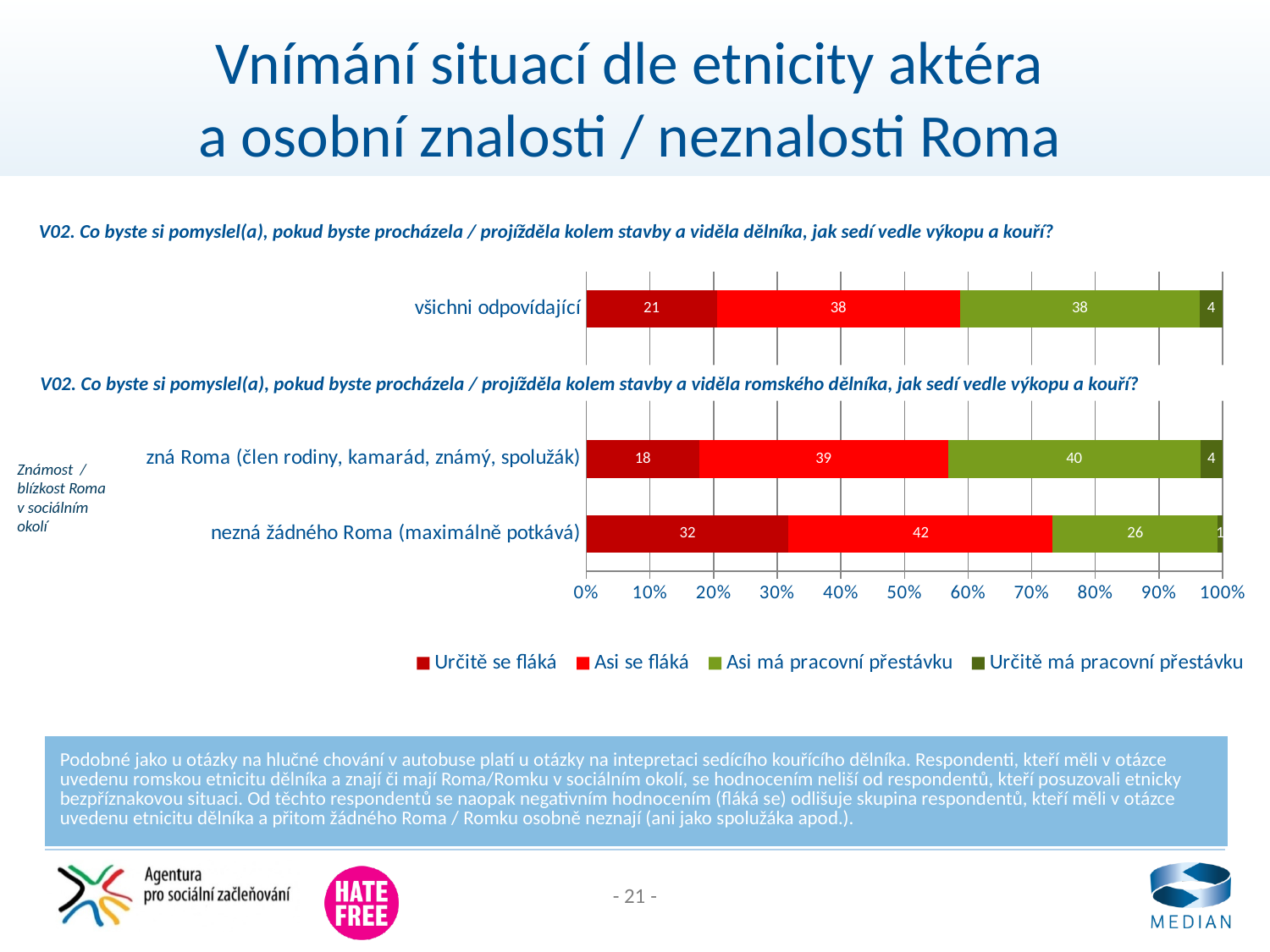
In the bottom chart, what is the value of 'Asi má pracovní přestávku' for 'zná Roma (člen rodiny, kamarád, známý, spolužák)'? 40 In the bottom chart, what is the value of 'Určitě má pracovní přestávku' for 'nezná žádného Roma (maximálně potkává)'? 1 Which legend entry is shown in dark green? Určitě má pracovní přestávku How many series does the legend list? 4 What kind of chart is used on the slide? stacked bar chart In the top chart, what is the combined value of 'Určitě se fláká' and 'Asi se fláká' for 'všichni odpovídající'? 59 In the bottom chart, which category has the higher value for 'Určitě se fláká'? nezná žádného Roma (maximálně potkává) In the top chart (všichni odpovídající), what is the value for 'Určitě se fláká'? 21 In the bottom chart, is 'Asi má pracovní přestávku' larger for 'zná Roma' or for 'nezná žádného Roma'? zná Roma (člen rodiny, kamarád, známý, spolužák) How many categories are shown in the bottom chart? 2 In the bottom chart, what is the difference in 'Určitě se fláká' between 'nezná žádného Roma' and 'zná Roma'? 14 In the bottom chart, what is the value of 'Asi se fláká' for 'nezná žádného Roma (maximálně potkává)'? 42